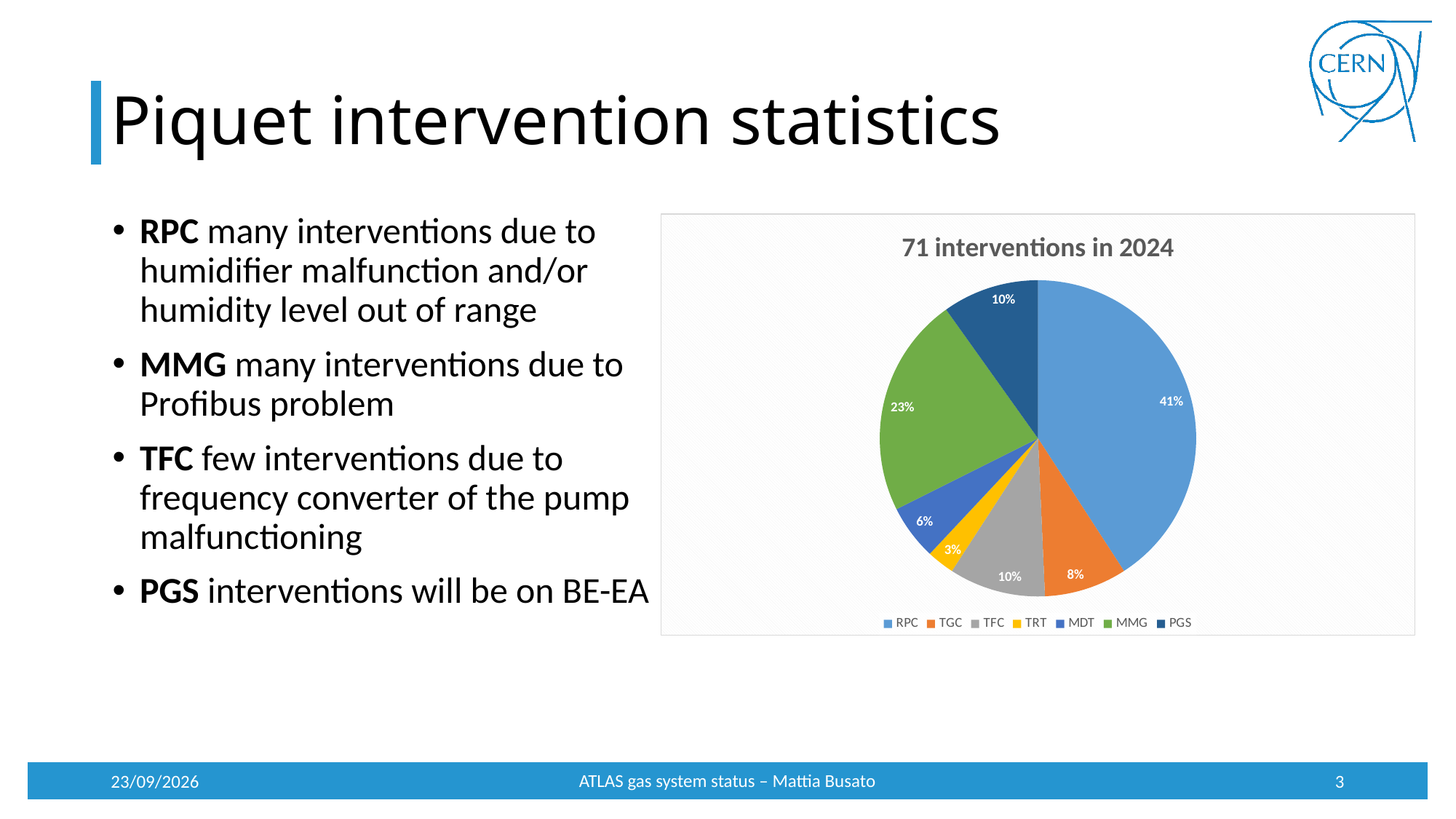
What share of interventions is attributed to MMG? 23% What is the title of the chart? 71 interventions in 2024 What is the difference in percentage points between the RPC and MMG shares? 18 Which system accounts for the smallest share of interventions? TRT What share of interventions is attributed to RPC? 41% How many systems are listed in the chart legend? 7 Which has a larger share of interventions, TGC or MDT? TGC What share of interventions is attributed to TGC? 8% What kind of chart is shown on the slide? pie chart Which system accounts for the largest share of interventions? RPC